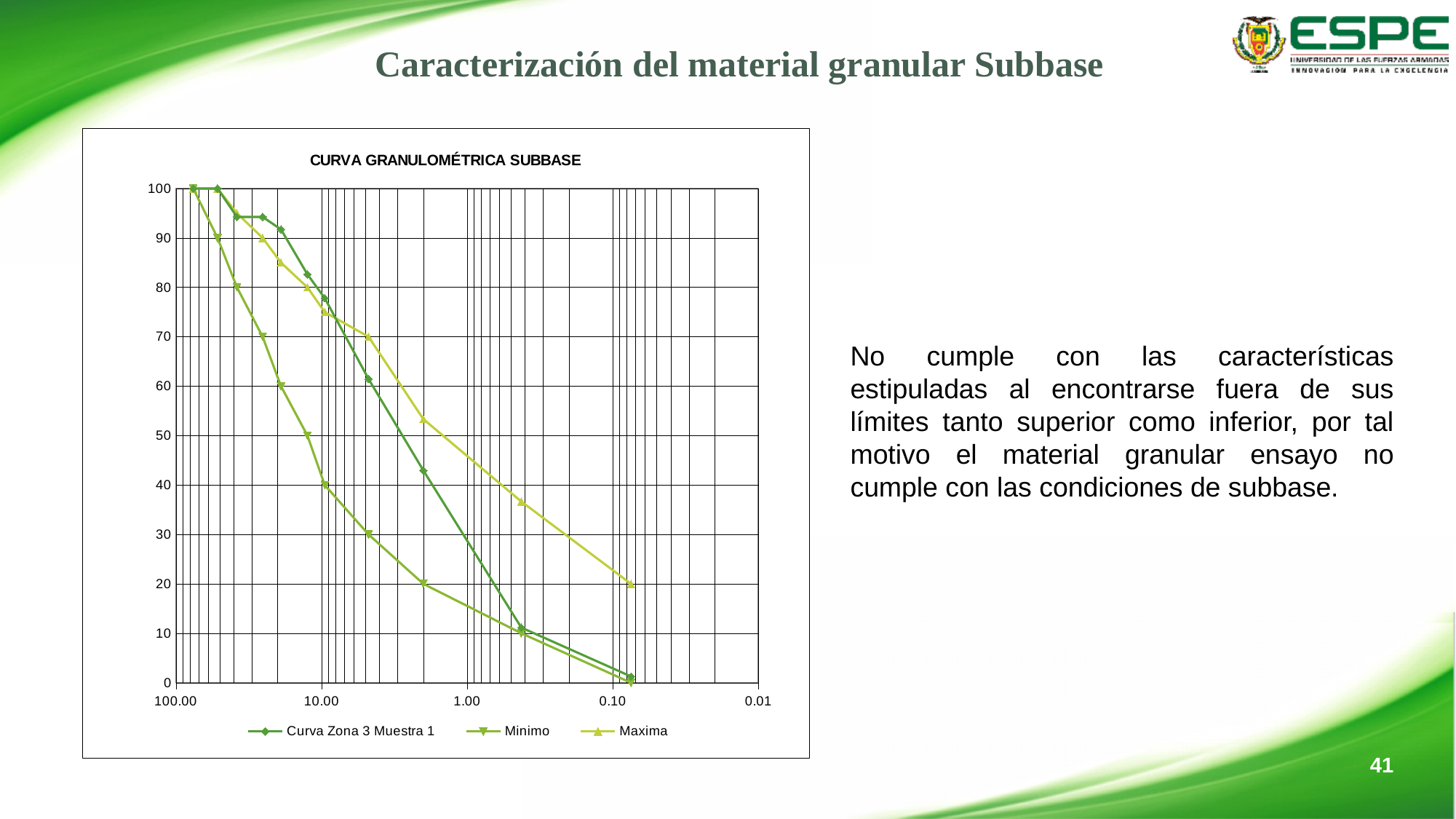
How many series does the legend of the chart list? 3 Is the value of the Curva Zona 3 Muestra 1 series at x = 10.00 greater or less than 70? greater What kind of chart is shown on the slide? Line chart Is the value of the Minimo series at x = 10.00 greater or less than 50? less Is the value of the Maxima series at x = 10.00 greater or less than 70? greater Which series has the lowest value at x = 10.00? Minimo What is the title of the chart? CURVA GRANULOMÉTRICA SUBBASE What is the value of the Minimo series at its leftmost point? 100 At x = 10.00, which series has the larger value, Maxima or Minimo? Maxima Do the values of the Curva Zona 3 Muestra 1 series rise or fall moving from left to right along the x axis? Fall Which series are listed in the chart legend? Curva Zona 3 Muestra 1, Minimo, Maxima